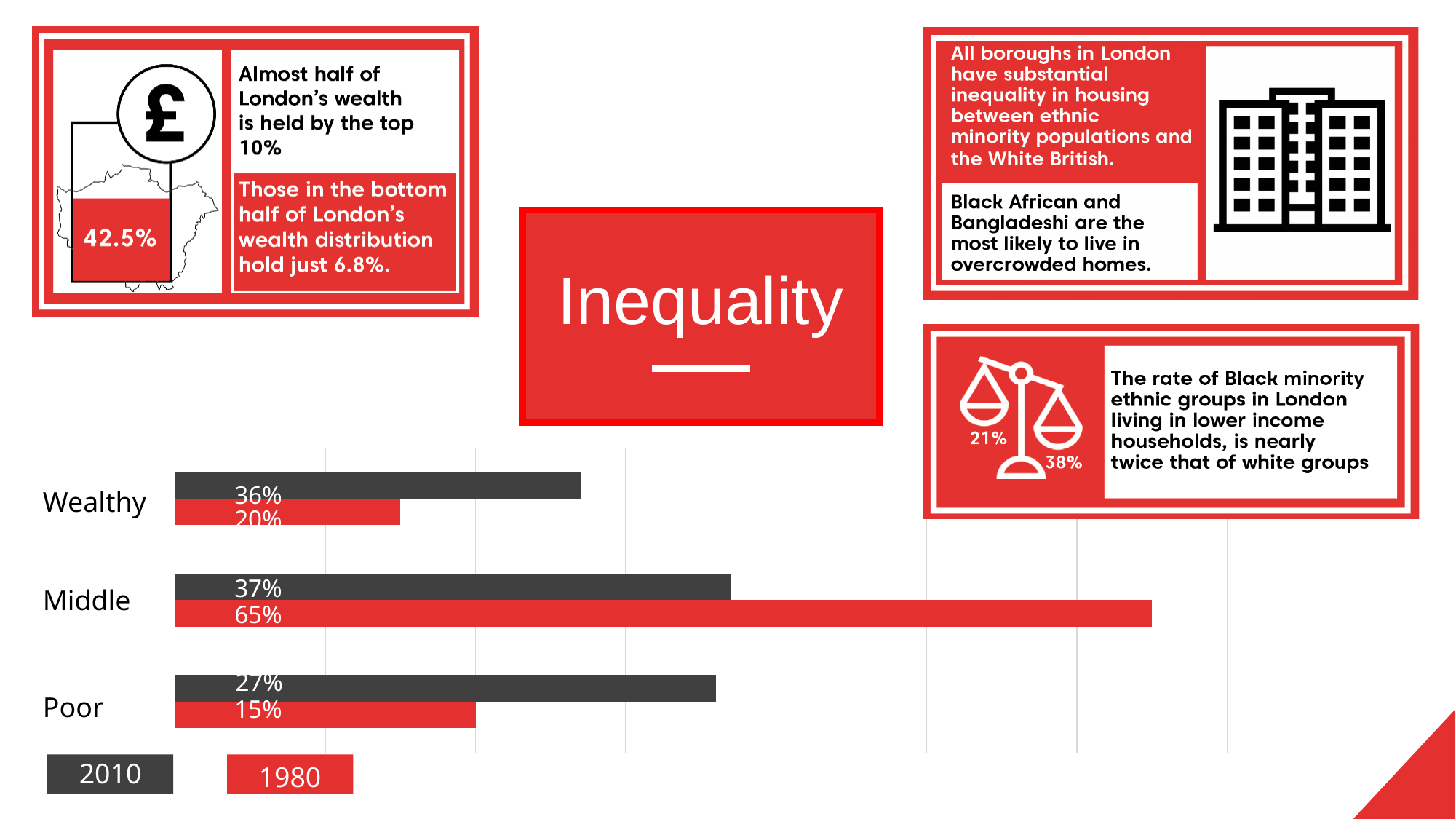
Which category has the lowest 1980 value? Poor Which category has the highest 1980 value? Middle What is the difference between the 1980 and 2010 values for the Middle category? 28% How many categories are shown in the bar chart? 3 What is the 2010 value for the Poor category? 27% What kind of chart is shown on the slide? Bar chart What is the 1980 value for the Poor category? 15% What is the 2010 value for the Wealthy category? 36% Which category has the lowest 2010 value? Poor How many series does the chart's legend list? 2 What is the 1980 value for the Middle category? 65% Which is larger for the Wealthy category: the 2010 value or the 1980 value? 2010